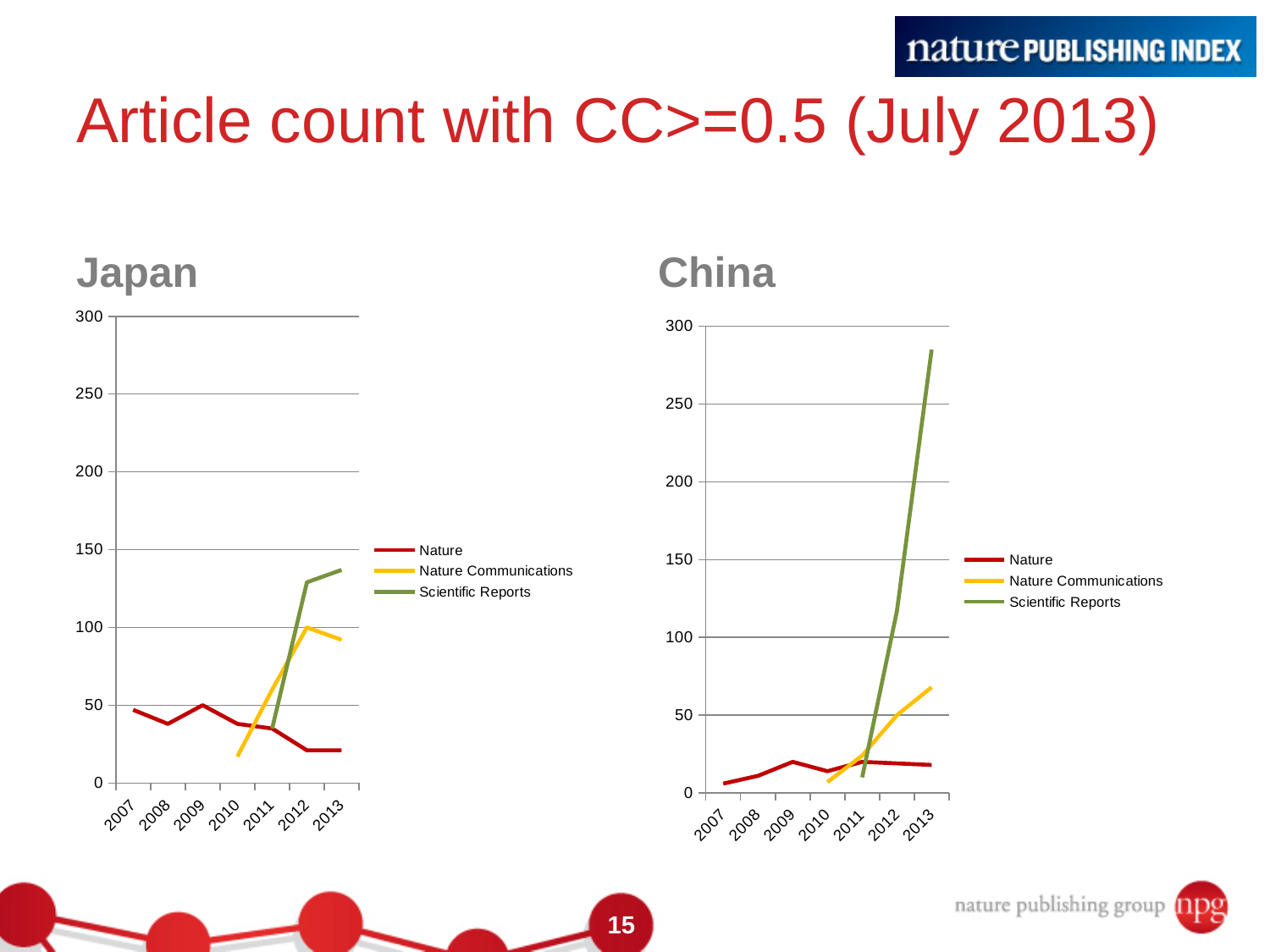
In the China chart, which series has the higher value in 2013, Scientific Reports or Nature Communications? Scientific Reports What kind of chart is the Japan chart? line chart In the Japan chart, which series has the higher value in 2013, Nature Communications or Nature? Nature Communications Which series is drawn in green in the China chart? Scientific Reports In the Japan chart, is the value for Scientific Reports in 2013 greater or less than 100? greater In the China chart, is the value for Scientific Reports in 2013 greater or less than 250? greater In the China chart, does the Scientific Reports series rise or fall from 2011 to 2013? rise In the Japan chart, is the value for Nature in 2013 greater or less than 50? less In the Japan chart, does the Nature series rise or fall overall from 2007 to 2013? fall How many years are shown on the x axis of the Japan chart? 7 How many series does the legend of the China chart list? 3 In the Japan chart, which series has the highest value in 2013? Scientific Reports